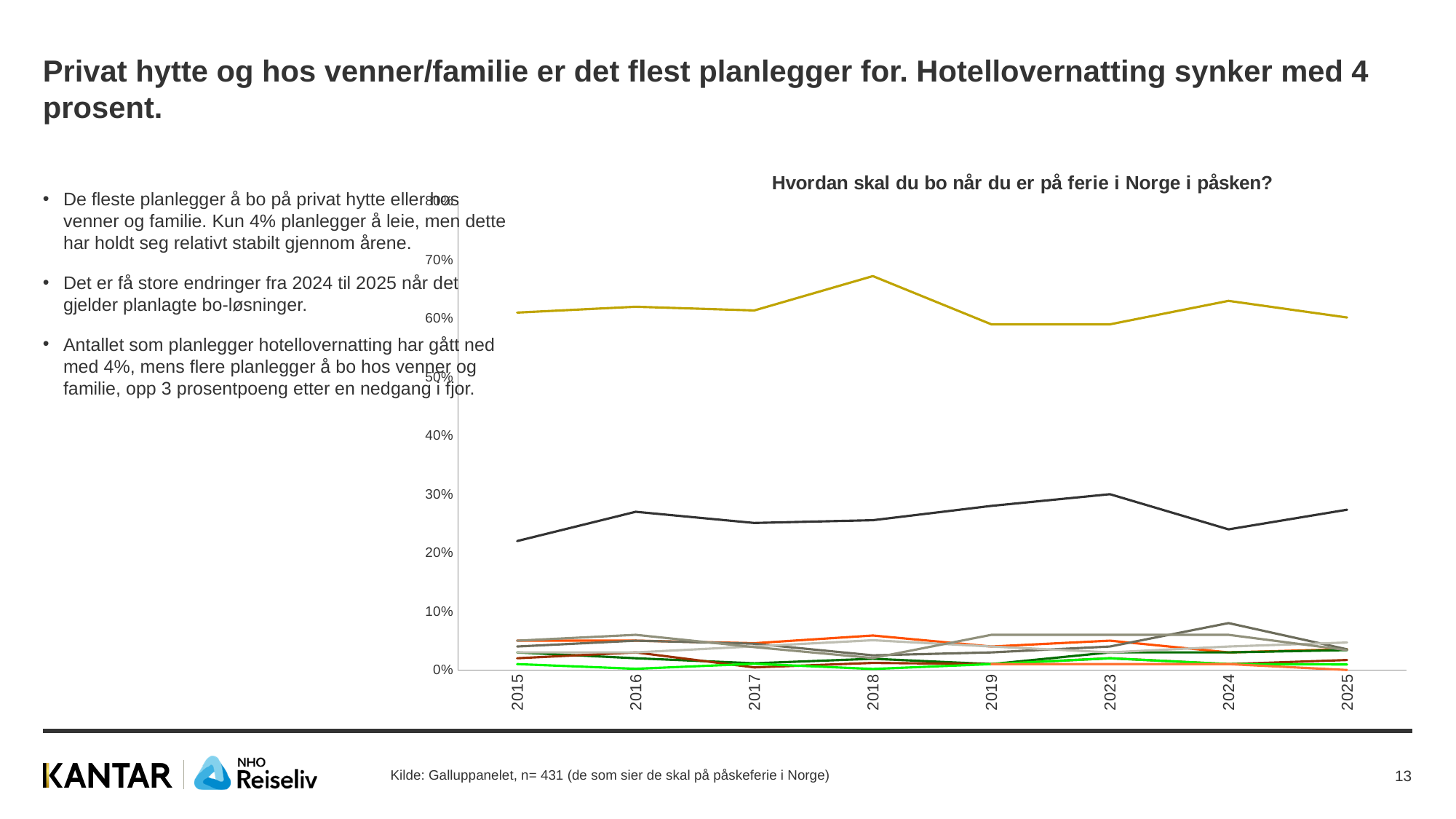
Is the value of the yellow line in 2019 greater or less than 70%? less What kind of chart is shown on the slide? line chart Is the value of the black line in 2015 greater or less than 30%? less In which year does the yellow (top) line reach its highest point? 2018 Does the yellow line rise or fall from 2018 to 2019? fall In which year is the black line at its lowest point? 2015 Which is larger for the yellow line: the value in 2018 or the value in 2025? 2018 Is the value of the black line in 2024 greater or less than 20%? greater What is the title of the chart? Hvordan skal du bo når du er på ferie i Norge i påsken? How many years are shown along the x axis of the chart? 8 What is the highest value shown on the chart's y axis? 80%